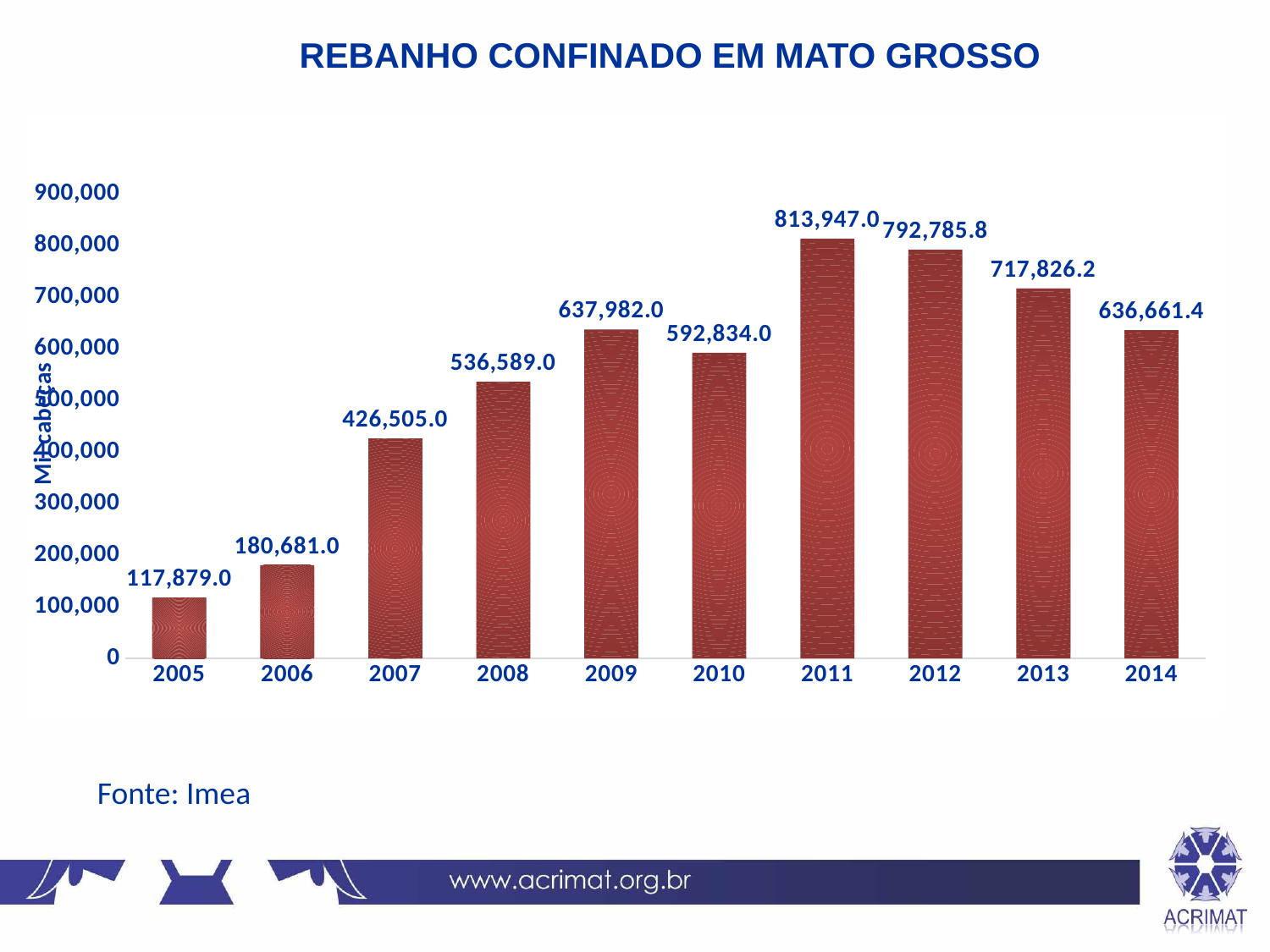
Which year has the lowest value? 2005 Which is larger, the value for 2009 or the value for 2014? 2009 What is the value for 2005? 117,879.0 What is the value for 2011? 813,947.0 What is the difference between the values for 2011 and 2012? 21,161.2 What kind of chart is this? Bar chart How many years are shown on the x axis? 10 From 2011 to 2014, do the values rise or fall? Fall What is the difference between the values for 2009 and 2010? 45,148.0 What is the value for 2014? 636,661.4 What is the value for 2008? 536,589.0 Which year has the highest value? 2011